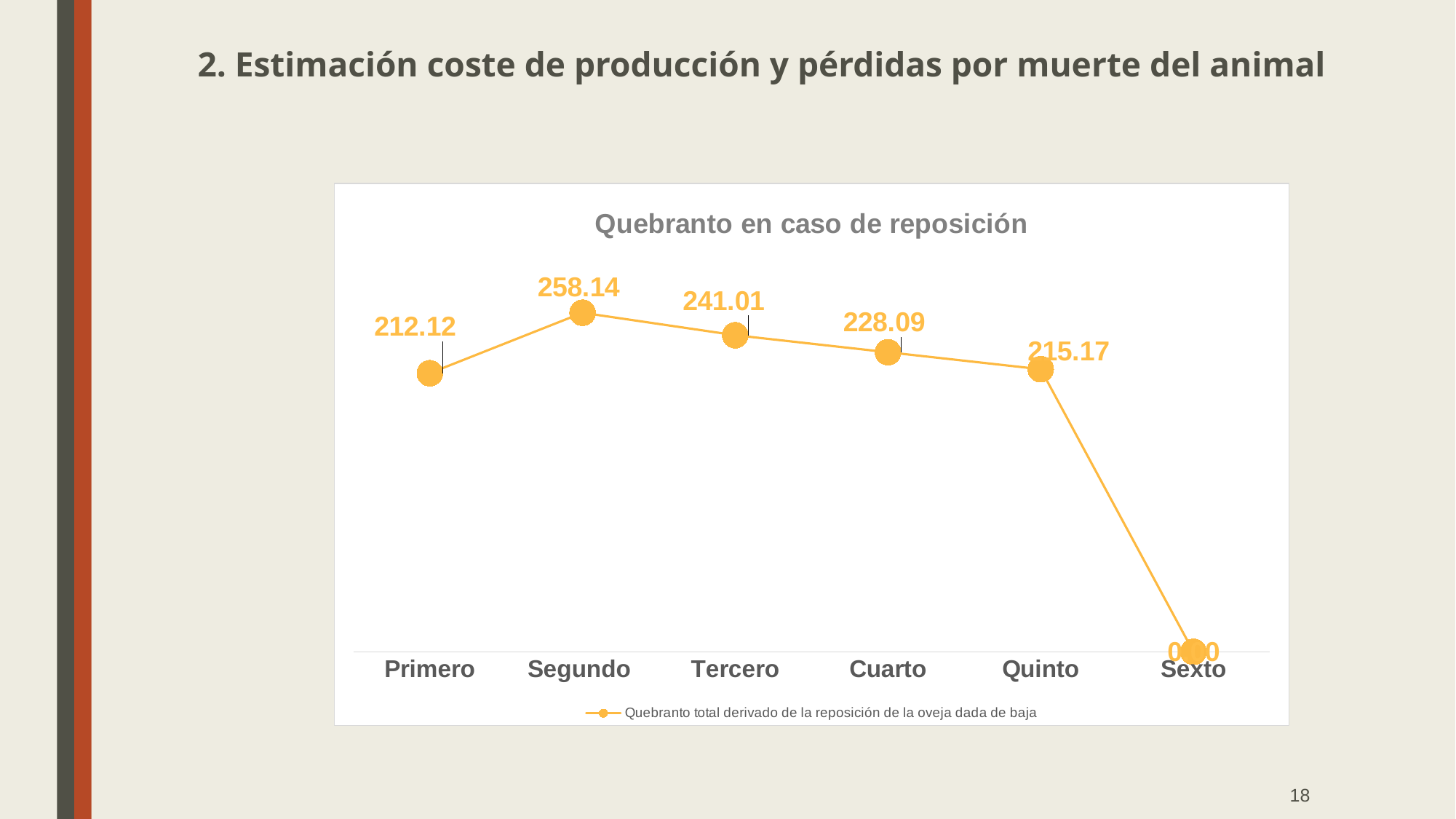
What is the value for Cuarto in the chart? 228.09 What is the value for Primero in the chart? 212.12 How many categories are plotted along the x axis? 6 Which category has the highest value in the chart? Segundo What is the value for Segundo in the chart? 258.14 Which is larger, the value for Tercero or the value for Quinto? Tercero What is the value for Tercero in the chart? 241.01 What type of chart is shown on the slide? line chart What is the difference between the values for Segundo and Primero? 46.02 What is the title of the chart? Quebranto en caso de reposición Which category has the lowest value in the chart? Sexto What is the value for Quinto in the chart? 215.17